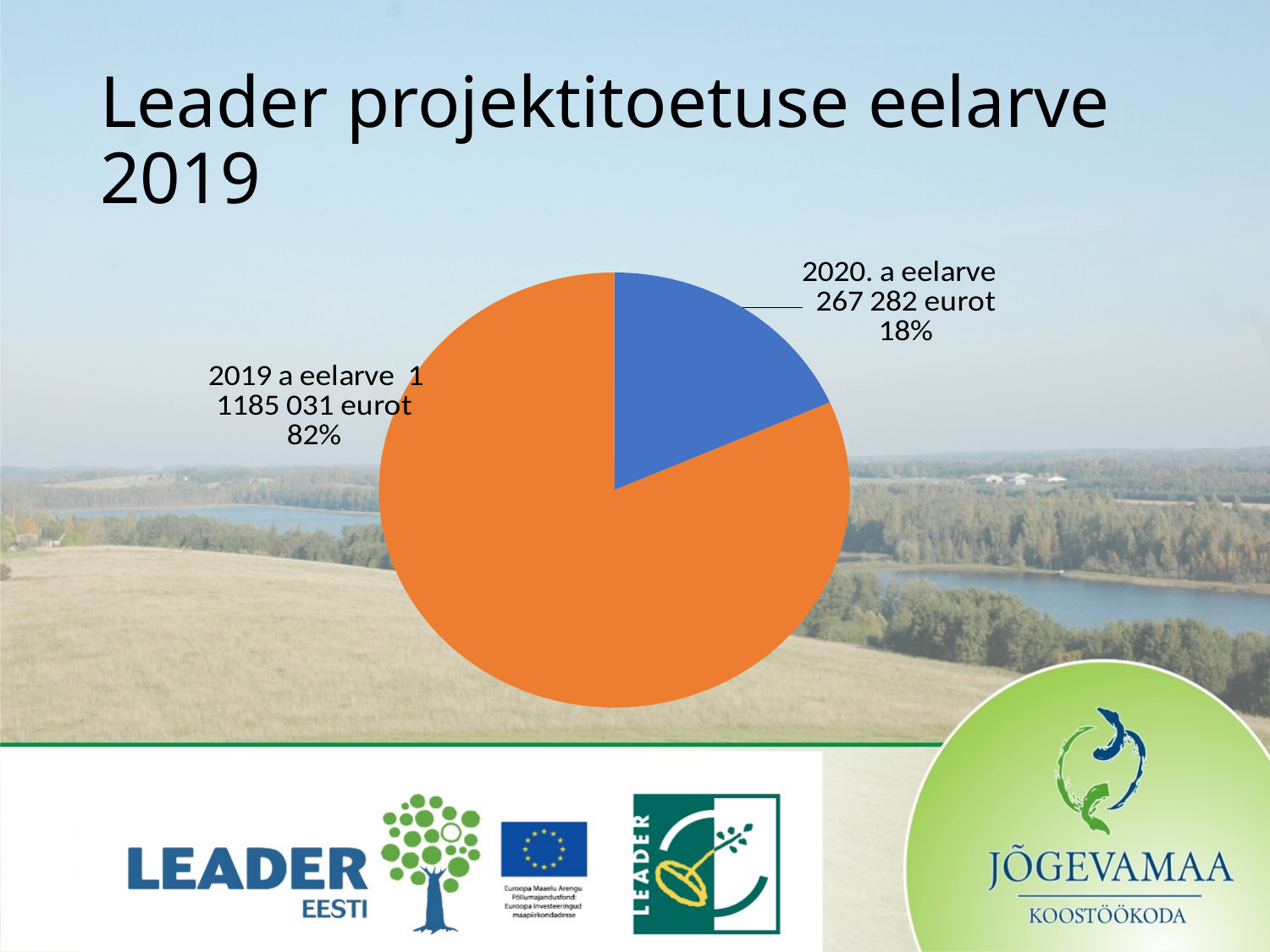
What colour is the 2020. a eelarve slice? blue What is the title of the slide containing the pie chart? Leader projektitoetuse eelarve 2019 Which is larger, the 2019 a eelarve slice or the 2020. a eelarve slice? 2019 a eelarve What is the euro amount shown for 2020. a eelarve? 267 282 eurot Which slice is the smallest in the pie chart? 2020. a eelarve What share of the pie does the 2020. a eelarve slice represent? 18% How many slices does the pie chart have? 2 What share of the pie does the 2019 a eelarve slice represent? 82% What is the difference in percentage points between the 2019 a eelarve share and the 2020. a eelarve share? 64 percentage points Which slice is the largest in the pie chart? 2019 a eelarve What kind of chart is shown on the slide? pie chart